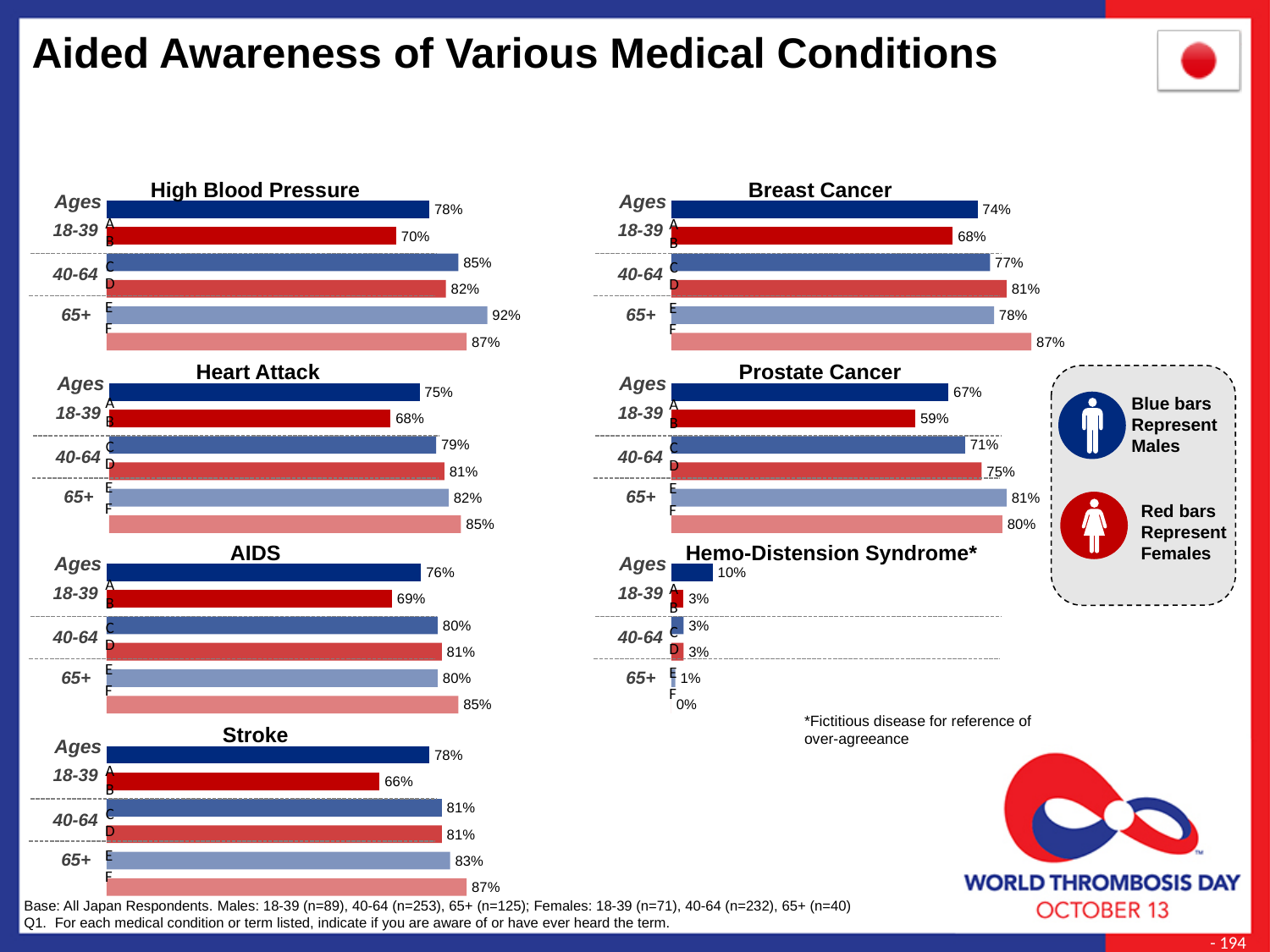
In the AIDS chart, which is larger: the value for males aged 40-64 or females aged 40-64? Females 40-64 (81%) In the Prostate Cancer chart, what is the difference between males aged 18-39 and females aged 18-39? 8% How many bars are plotted in the Stroke chart? 6 In the High Blood Pressure chart, what is the value for males aged 65+? 92% In the Stroke chart, which bar has the lowest value? Females 18-39 (66%) In the Hemo-Distension Syndrome chart, what is the value for males aged 18-39? 10% What type of chart is used for High Blood Pressure? Bar chart In the Hemo-Distension Syndrome chart, what is the value for females aged 65+? 0% In the Heart Attack chart, do the values for males rise or fall as age increases from 18-39 to 65+? Rise In the Breast Cancer chart, which bar has the highest value? Females 65+ (87%) According to the legend box, what do the red bars represent? Females In the Heart Attack chart, what is the value for females aged 18-39? 68%